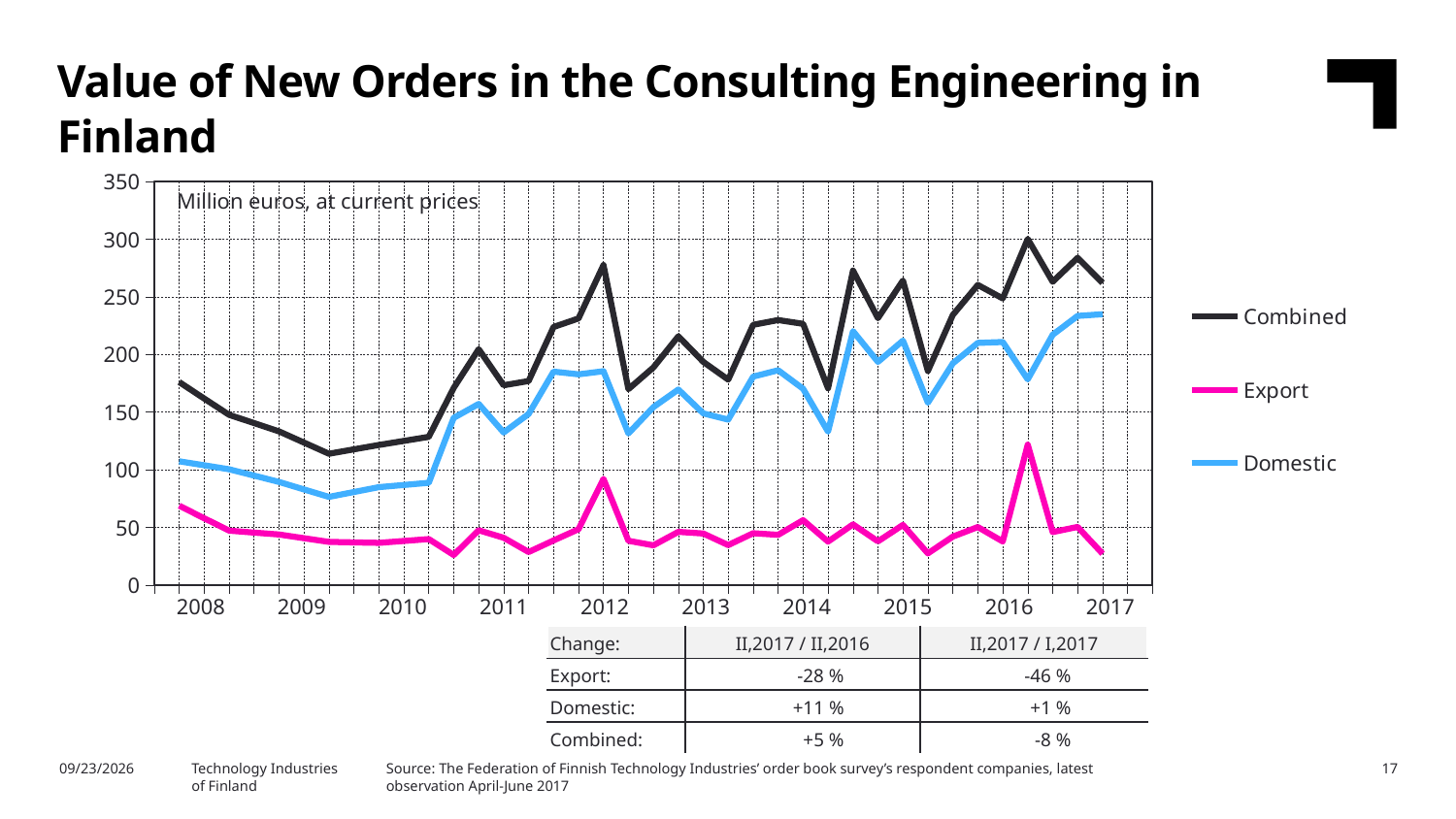
Is the Domestic value at its low point in 2009 greater or less than 100? less Is the Export value at its 2016 peak greater or less than 100? greater What kind of chart is shown on the slide? line chart Which series has the highest values throughout the chart? Combined Which series has the lowest values throughout the chart? Export Is the Domestic value at the last point in 2017 greater or less than 200? greater Which series is plotted in pink? Export How many series does the legend list? 3 How many years are labelled on the x axis? 10 Which is larger at the start of 2008, the Combined value or the Domestic value? Combined What unit is stated inside the chart area? Million euros, at current prices Does the Combined series rise or fall from 2008 to 2009? fall